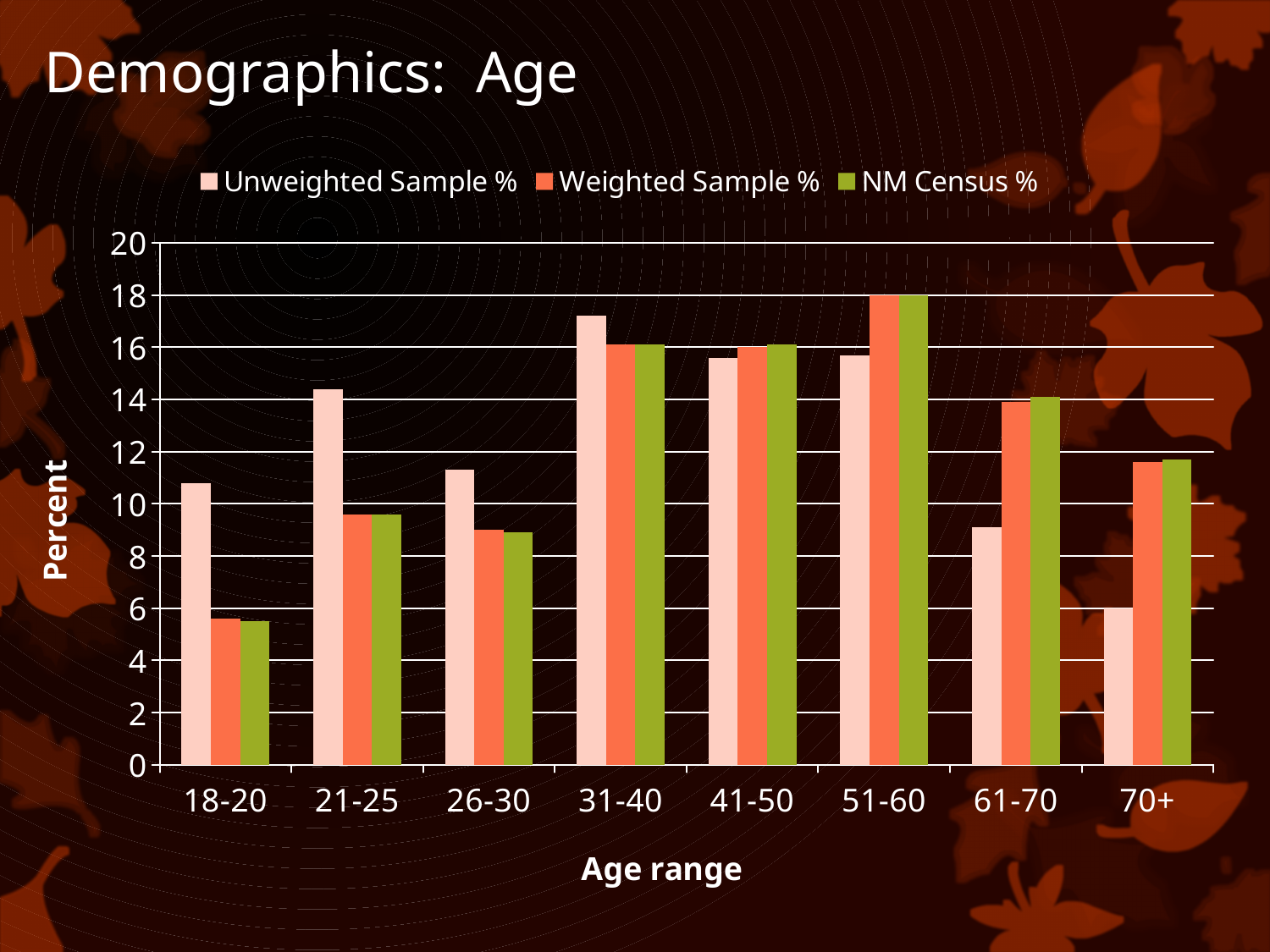
Is the Unweighted Sample % value for 18-20 greater or less than 10? greater Is the NM Census % value for 61-70 greater or less than 12? greater Which age range has the lowest Unweighted Sample % value? 70+ Is the Weighted Sample % value for 70+ greater or less than 10? greater Which age range has the highest Weighted Sample % value? 51-60 For the 18-20 age range, which is larger: Unweighted Sample % or Weighted Sample %? Unweighted Sample % Which age range has the lowest NM Census % value? 18-20 What kind of chart is shown on the slide? bar chart What is the title of the y axis? Percent How many age range categories are shown on the x axis? 8 Which age range has the highest Unweighted Sample % value? 31-40 How many series does the legend list? 3